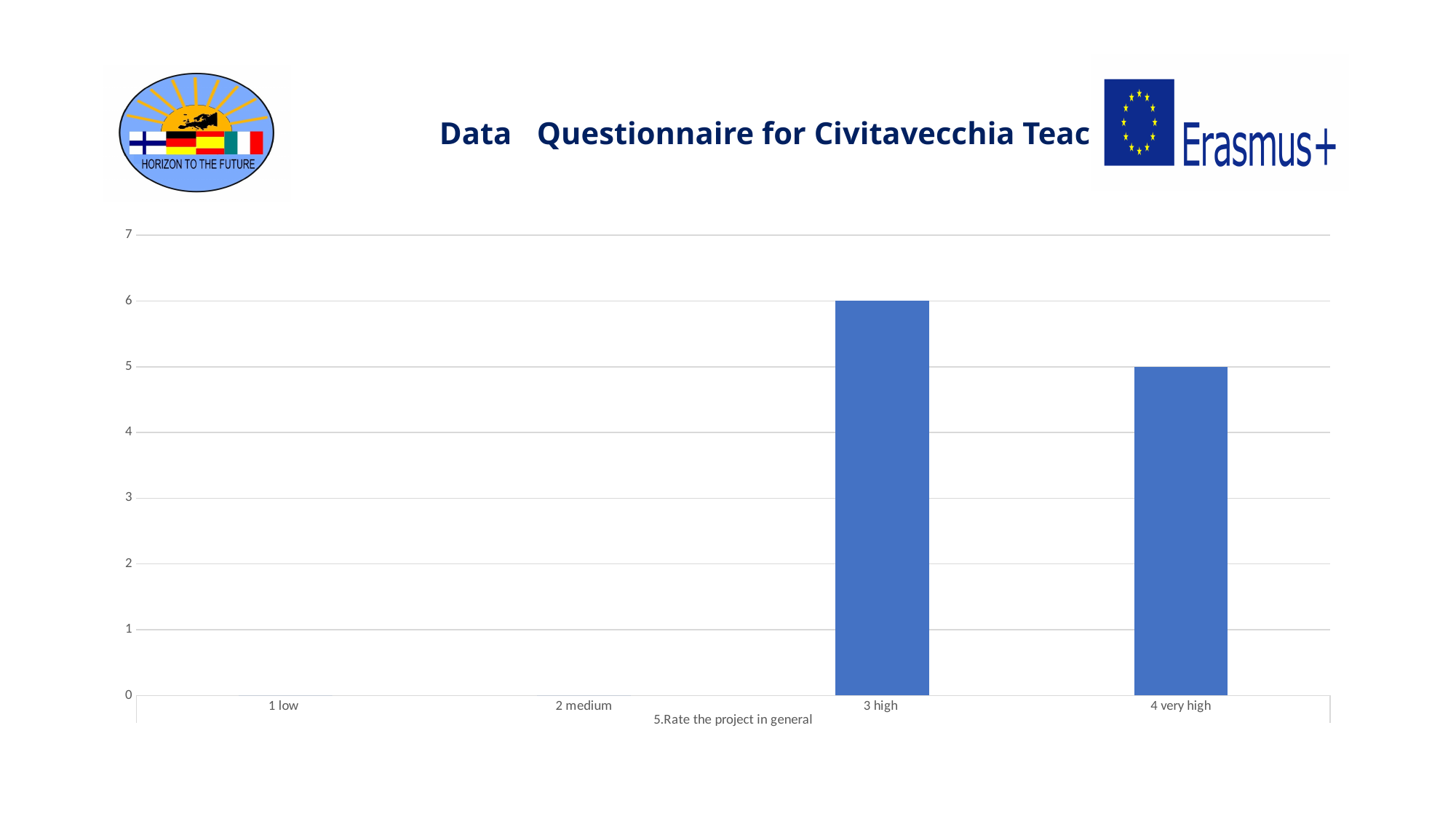
What is the difference between the values for "3 high" and "4 very high"? 1 Which categories have no visible bar? 1 low and 2 medium What is the value for "3 high"? 6 What is the highest value shown on the y axis? 7 How many categories are shown on the x axis? 4 Is the value for "3 high" greater or less than 4? greater Is the value for "4 very high" greater or less than 7? less Which category has the highest value? 3 high What is the label shown beneath the x axis categories? 5.Rate the project in general Which is larger, the value for "3 high" or the value for "4 very high"? 3 high What is the value for "4 very high"? 5 What kind of chart is shown on the slide? bar chart